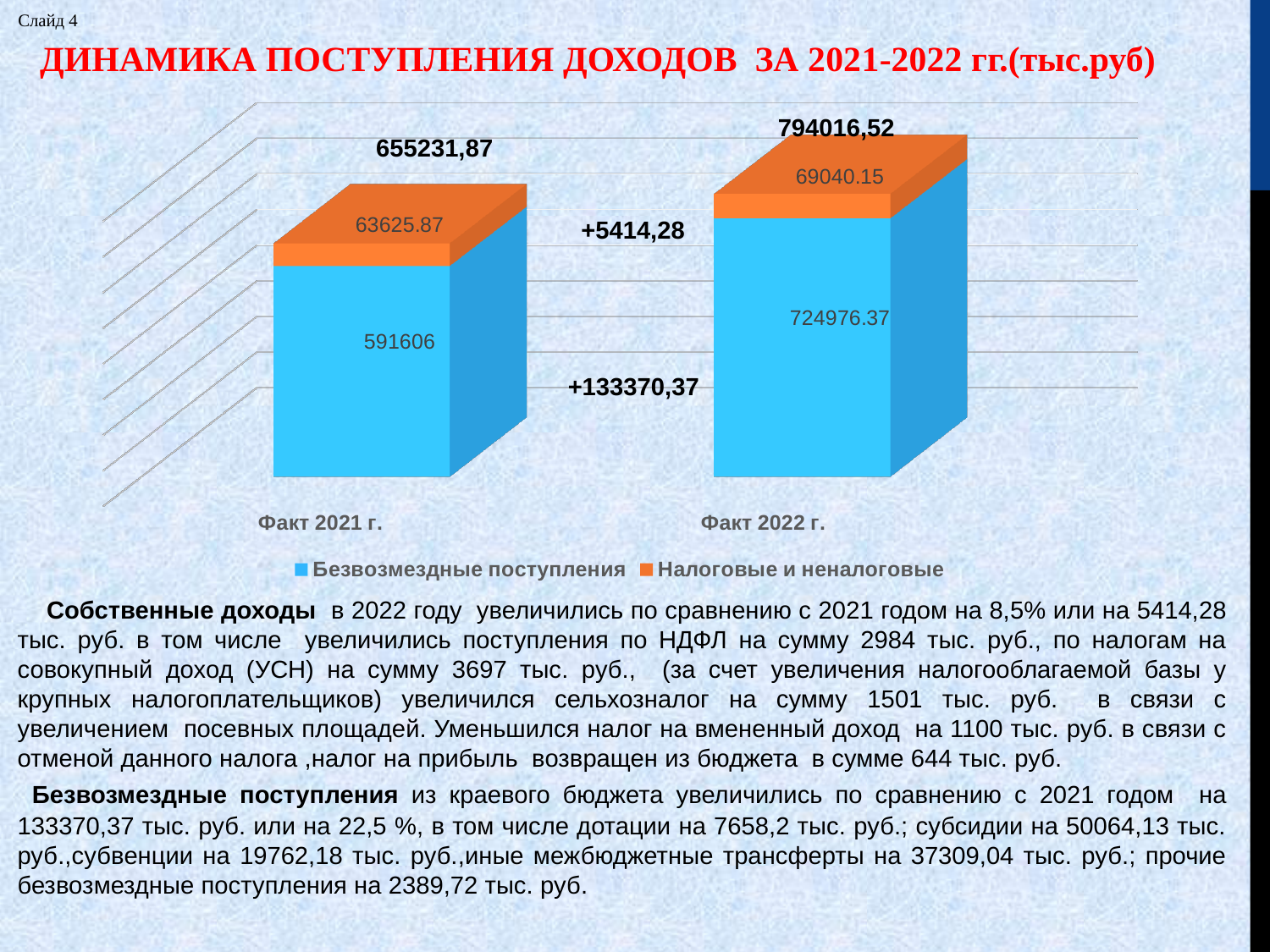
What is the value of Налоговые и неналоговые for Факт 2022 г.? 69040.15 How many categories are shown on the x axis of the chart? 2 What is the difference between the Безвозмездные поступления values for Факт 2022 г. and Факт 2021 г.? 133370.37 What is the value of Безвозмездные поступления for Факт 2021 г.? 591606 How many series does the chart legend list? 2 What is the total of the stacked bar for Факт 2021 г.? 655231,87 Which category has the higher total, Факт 2021 г. or Факт 2022 г.? Факт 2022 г. What is the value of Налоговые и неналоговые for Факт 2021 г.? 63625.87 What type of chart is shown on the slide? bar chart What is the value of Безвозмездные поступления for Факт 2022 г.? 724976.37 What is the total of the stacked bar for Факт 2022 г.? 794016,52 Which series is shown in orange in the chart legend? Налоговые и неналоговые